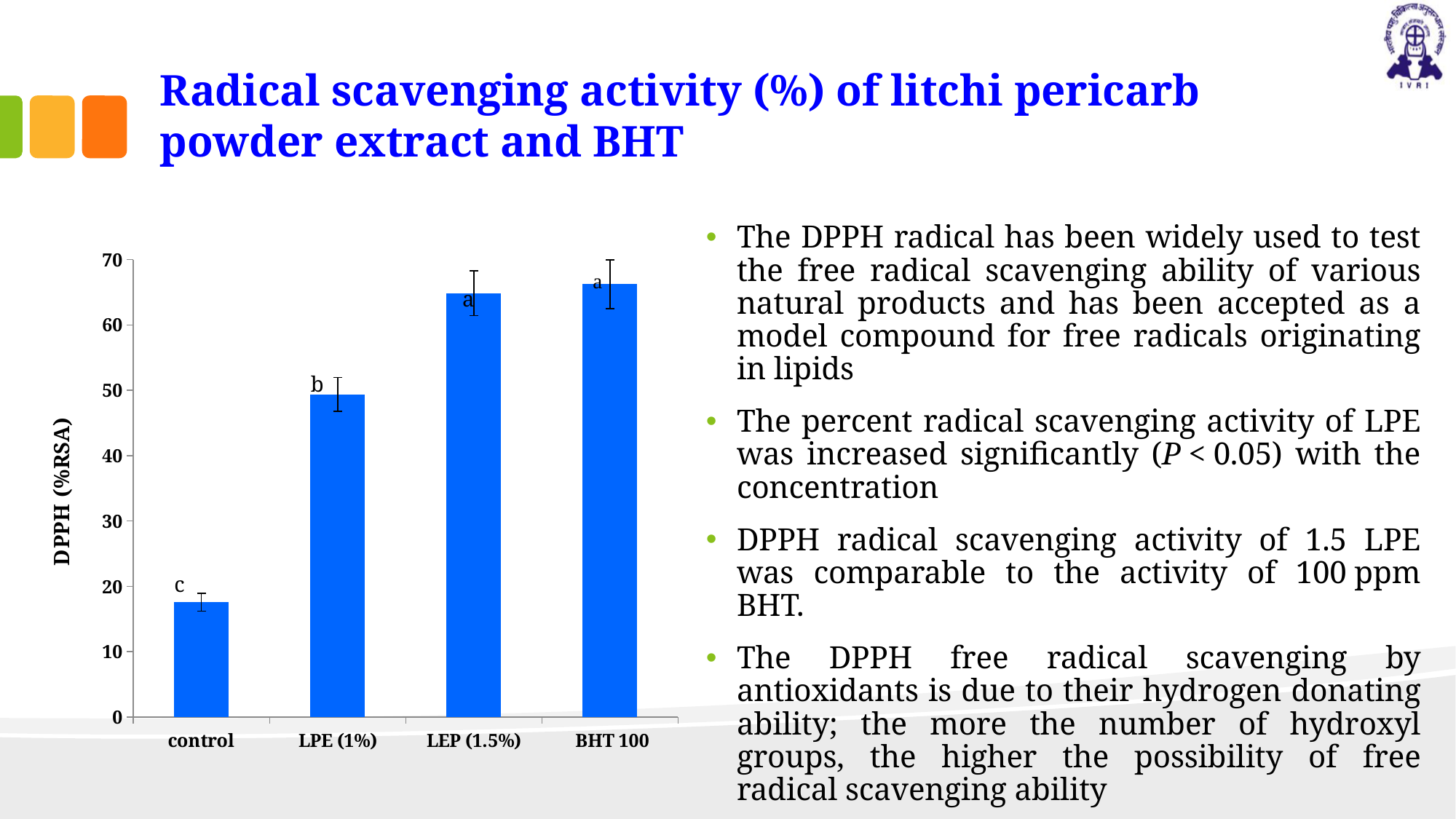
Is the value for LPE (1%) greater or less than 40? greater Is the value for control greater or less than 20? less Is the value for BHT 100 greater or less than 60? greater What kind of chart is shown on the slide? bar chart Which has a higher DPPH (%RSA) value, control or LPE (1%)? LPE (1%) Which has a higher DPPH (%RSA) value, LPE (1%) or LEP (1.5%)? LEP (1.5%) Do the bar values generally rise or fall from left to right along the x axis? rise How many categories are plotted on the x axis of the chart? 4 Which category has the lowest DPPH (%RSA) value? control What is the label of the y axis of the chart? DPPH (%RSA) What letter is printed above the control bar? c